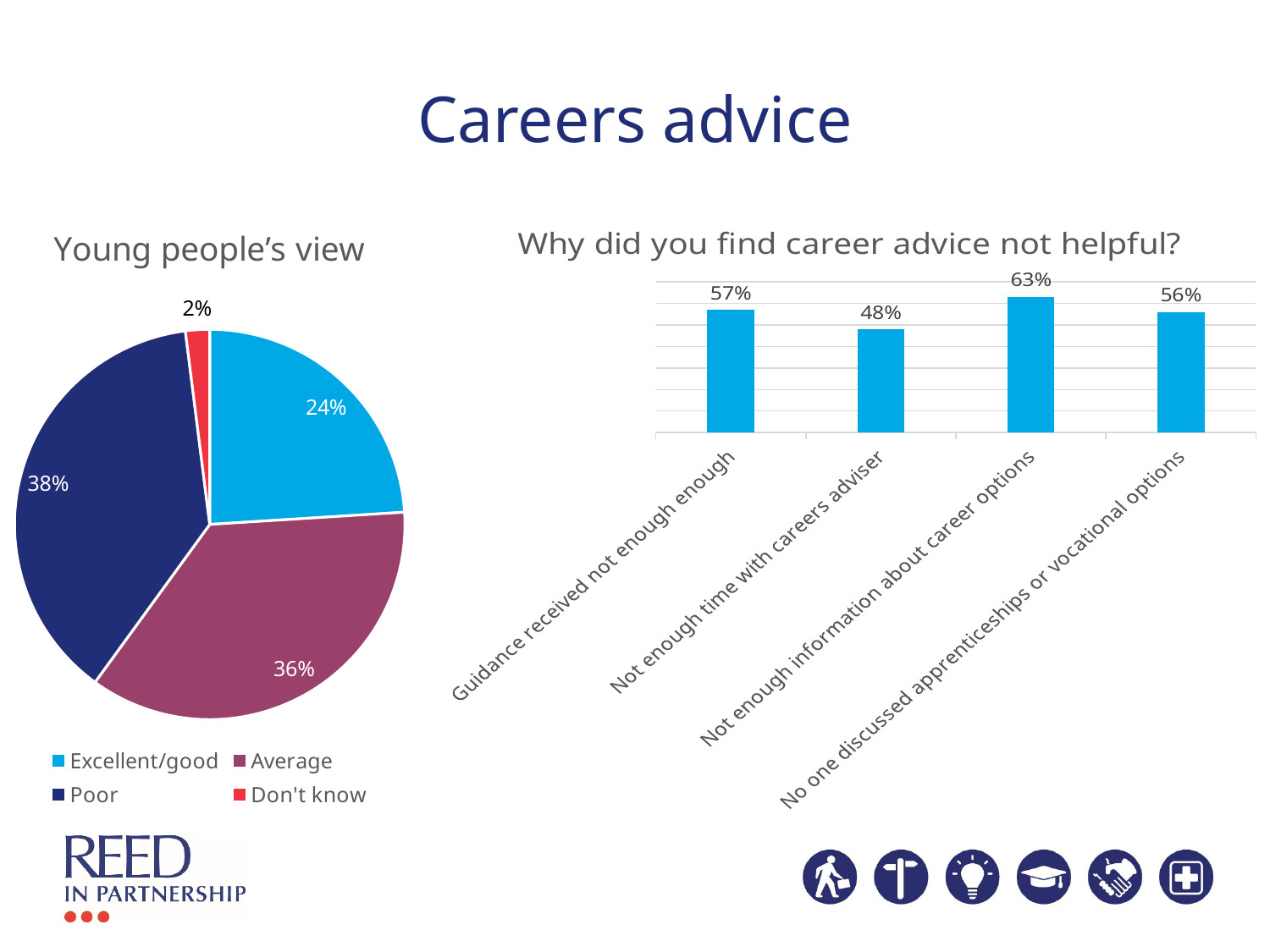
In the 'Young people's view' pie chart, what share of young people rated careers advice as Poor? 38% In the 'Young people's view' pie chart, how many categories does the legend list? 4 What type of chart is the 'Why did you find career advice not helpful?' chart? Bar chart In the 'Why did you find career advice not helpful?' chart, what is the difference between 'Not enough information about career options' and 'No one discussed apprenticeships or vocational options'? 7% What type of chart is the 'Young people's view' chart? Pie chart In the 'Young people's view' pie chart, which category has the largest slice? Poor In the 'Young people's view' pie chart, what share rated careers advice as Excellent/good? 24% In the 'Young people's view' pie chart, what is the difference between the Average and Excellent/good shares? 12% In the 'Why did you find career advice not helpful?' chart, which reason has the lowest value? Not enough time with careers adviser In the 'Young people's view' pie chart, which category has the smallest slice? Don't know In the 'Why did you find career advice not helpful?' chart, what is the value for 'Not enough time with careers adviser'? 48% In the 'Why did you find career advice not helpful?' chart, which reason has the highest value? Not enough information about career options